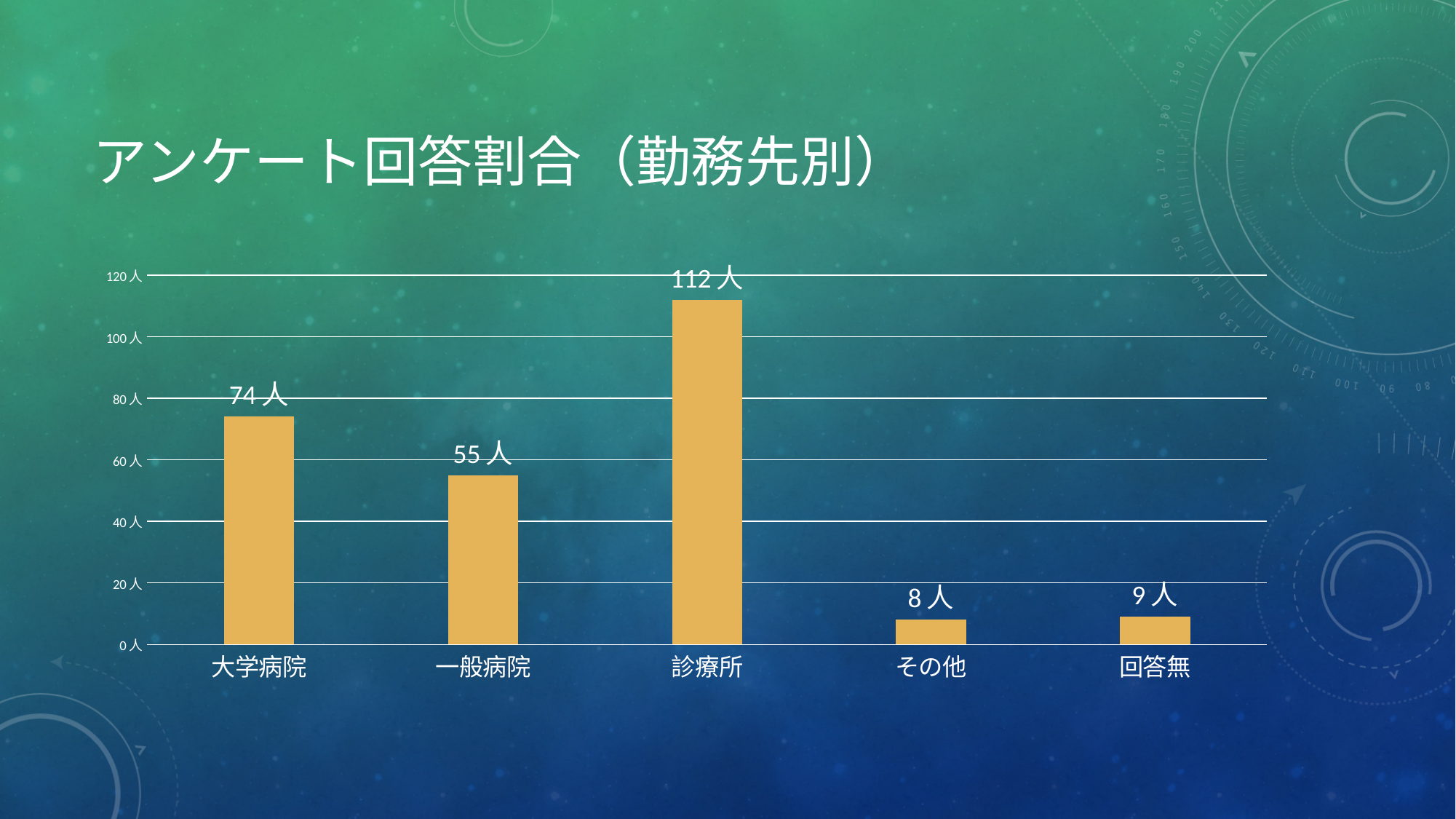
Which category has the highest value? 診療所 What is the value for 一般病院? 55人 What is the difference between the values for 診療所 and 大学病院? 38人 What is the difference between the values for 大学病院 and 一般病院? 19人 Which is larger, the value for 一般病院 or the value for 回答無? 一般病院 Which category has the lowest value? その他 How many categories are shown on the x axis? 5 What is the value for 大学病院? 74人 What kind of chart is shown on the slide? bar chart What is the title of the slide? アンケート回答割合（勤務先別） What is the value for 診療所? 112人 What is the value for 回答無? 9人